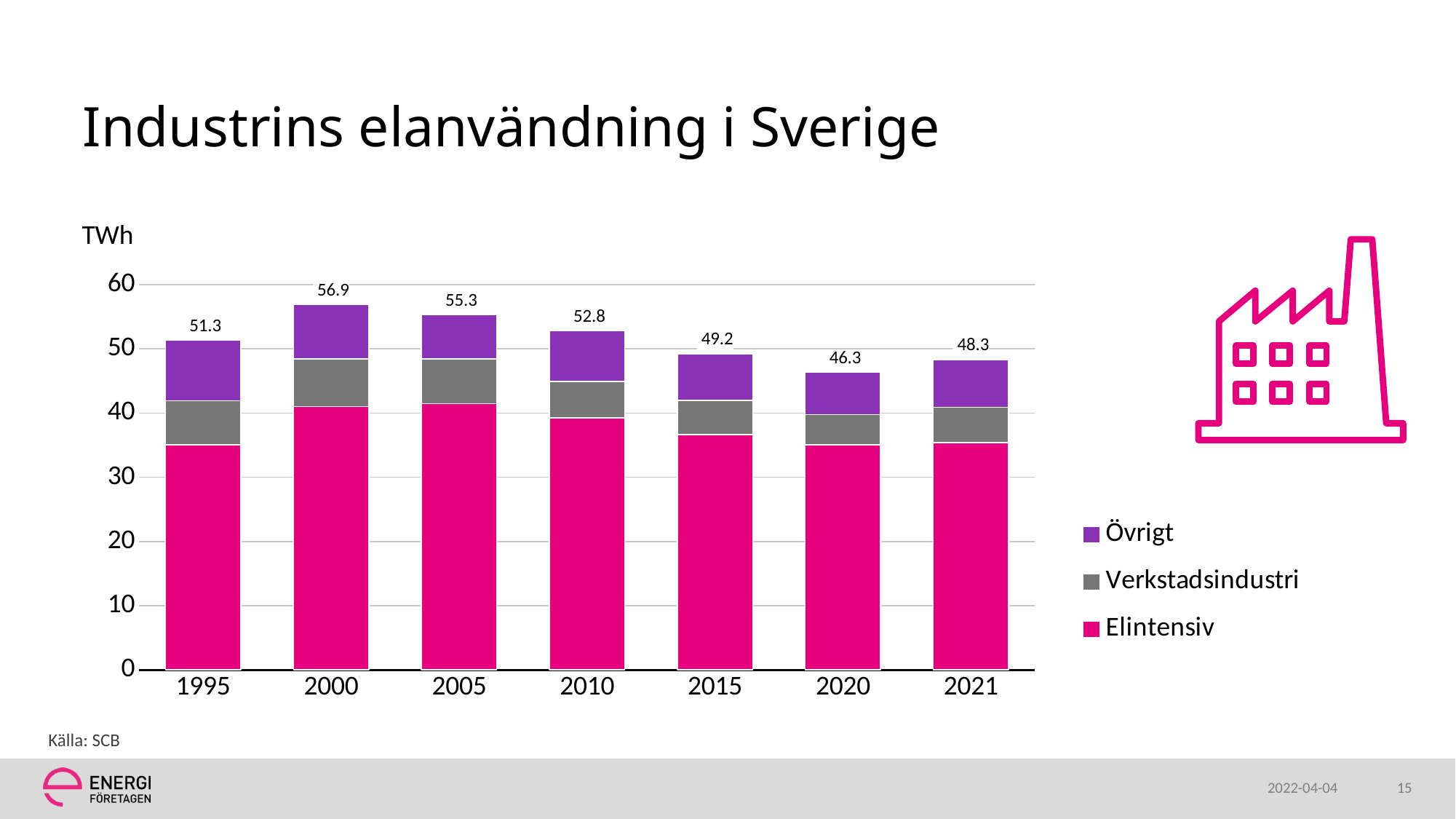
What kind of chart is shown? Stacked bar chart Do the totals rise or fall from 2000 to 2020? Fall What unit is shown on the y axis? TWh What is the total value for 2021? 48.3 Which year has the lowest total? 2020 What is the difference between the totals for 2000 and 2020? 10.6 Which year has the highest total? 2000 Is the Elintensiv value for 2015 greater or less than 40? less Which total is larger, 2015 or 2021? 2015 How many years are shown on the x axis? 7 What is the total value for 2000? 56.9 How many series does the legend list? 3